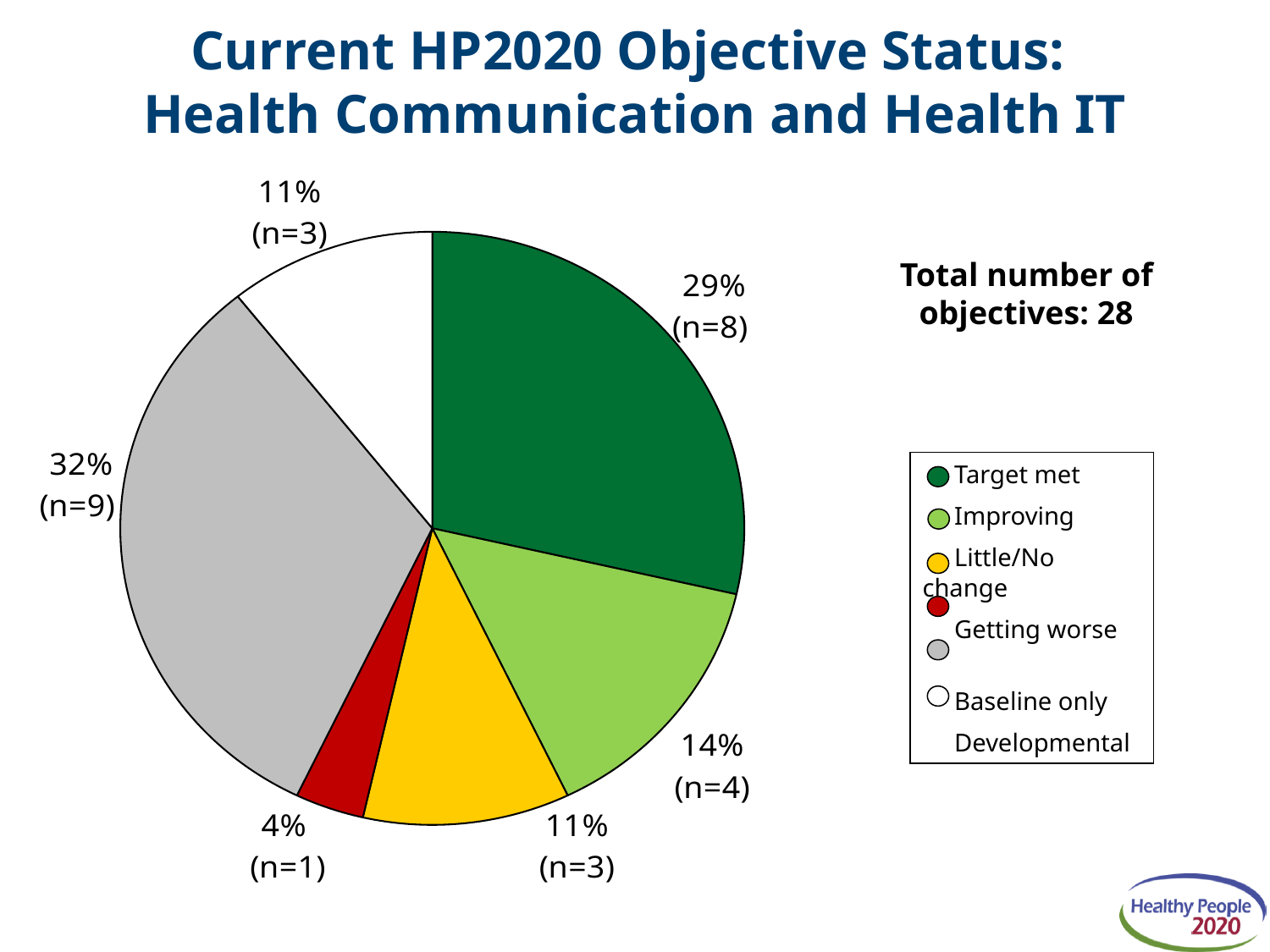
How many objectives are in the "Baseline only" category? n=9 What percentage of objectives have the status "Target met"? 29% What kind of chart is shown on the slide? pie chart How many status categories does the legend list? 6 Which is larger, the share for "Improving" or the share for "Little/No change"? Improving How many objectives are "Improving"? n=4 What is the difference in percentage points between "Baseline only" and "Target met"? 3 Which status category has the smallest share of the pie? Getting worse What is the total number of objectives stated on the slide? 28 Which status category has the largest share of the pie? Baseline only What percentage of objectives are "Getting worse"? 4% What colour is the "Target met" slice? dark green